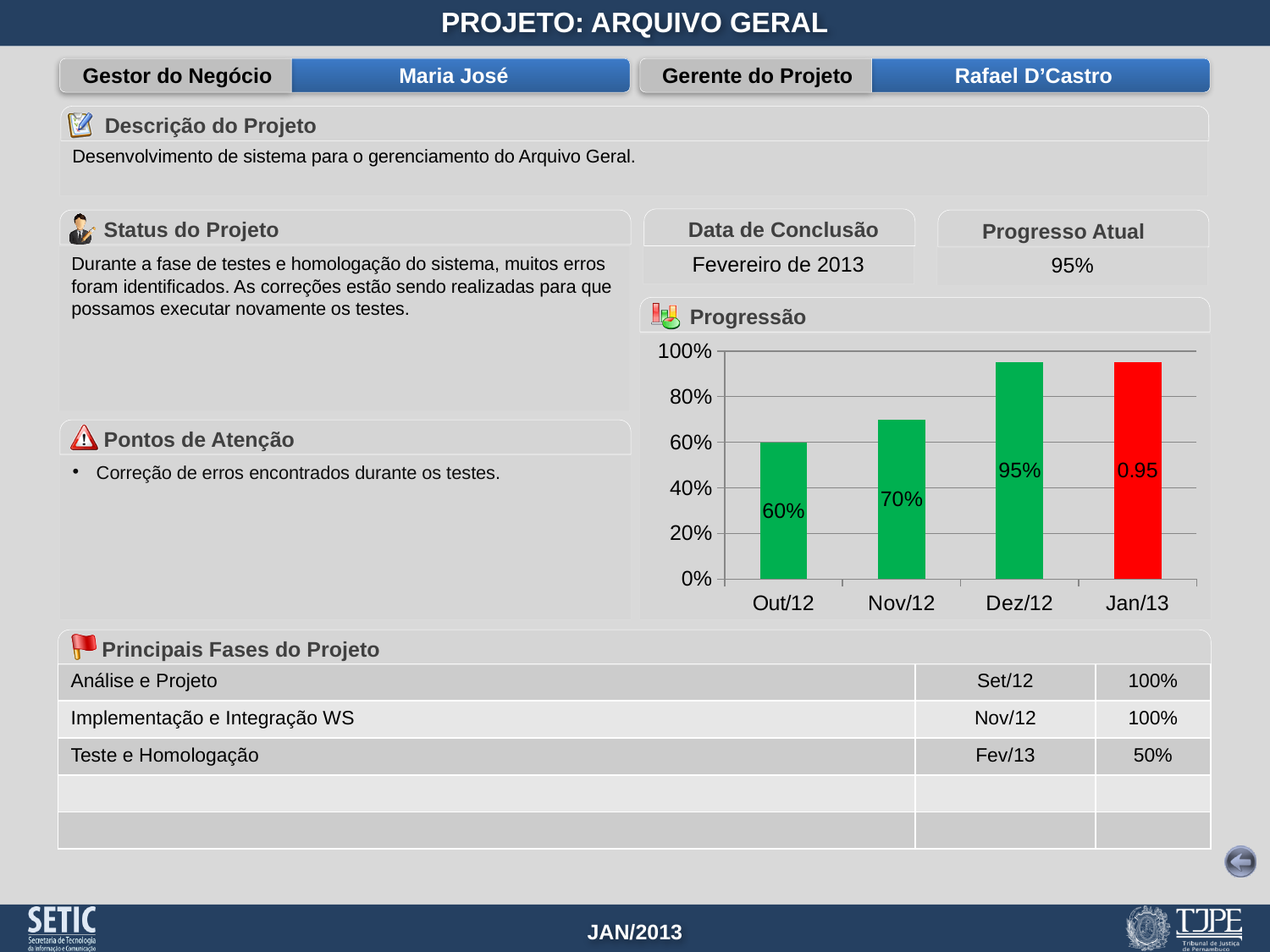
What is the difference between the values for Dez/12 and Out/12 in the Progressão chart? 35% Which bar in the Progressão chart is coloured red? Jan/13 How many months are shown on the x axis of the Progressão chart? 4 Which is larger in the Progressão chart, the value for Nov/12 or the value for Dez/12? Dez/12 Which month has the lowest value in the Progressão chart? Out/12 What kind of chart is the Progressão chart? bar chart What is the value for Out/12 in the Progressão chart? 60% What is the value for Nov/12 in the Progressão chart? 70% What is the value for Dez/12 in the Progressão chart? 95% What is the difference between the values for Nov/12 and Out/12 in the Progressão chart? 10% Is the value for Nov/12 in the Progressão chart greater or less than 80%? less What data label is shown on the Jan/13 bar in the Progressão chart? 0.95